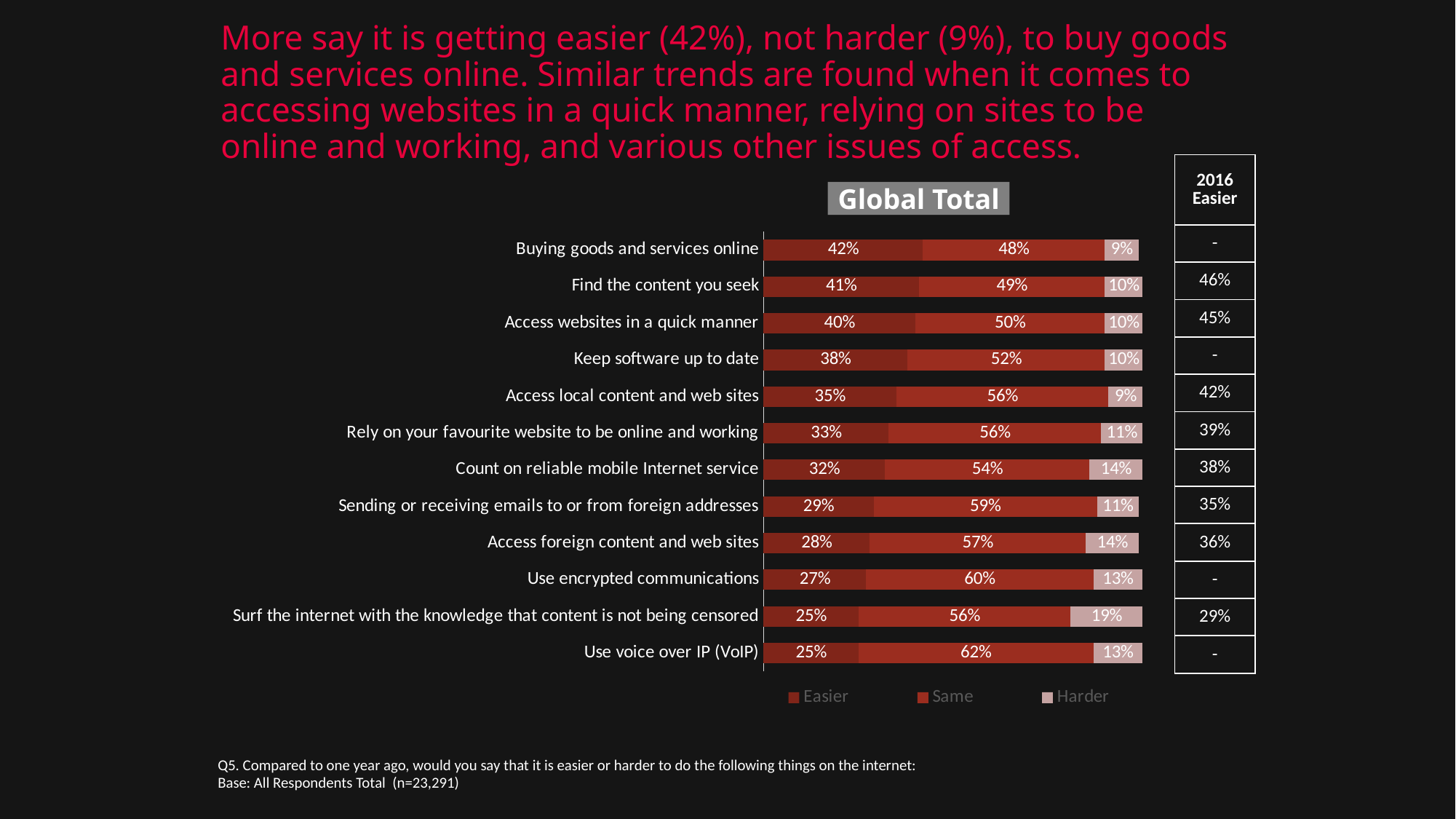
How many categories are shown in the chart? 12 What is the 'Same' value for 'Use voice over IP (VoIP)'? 62% What type of chart is shown on the slide? Stacked bar chart Which is larger: the 'Easier' value for 'Keep software up to date' or the 'Easier' value for 'Use encrypted communications'? Keep software up to date What percentage of respondents say it is easier to buy goods and services online? 42% Which category has the highest 'Easier' percentage? Buying goods and services online What is the 'Harder' value for 'Surf the internet with the knowledge that content is not being censored'? 19% Which category has the highest 'Harder' percentage? Surf the internet with the knowledge that content is not being censored What is the title of the chart? Global Total What is the total of the stacked bar for 'Count on reliable mobile Internet service'? 100% What is the difference between the 'Easier' and 'Harder' values for 'Buying goods and services online'? 33% How many series does the legend list? 3